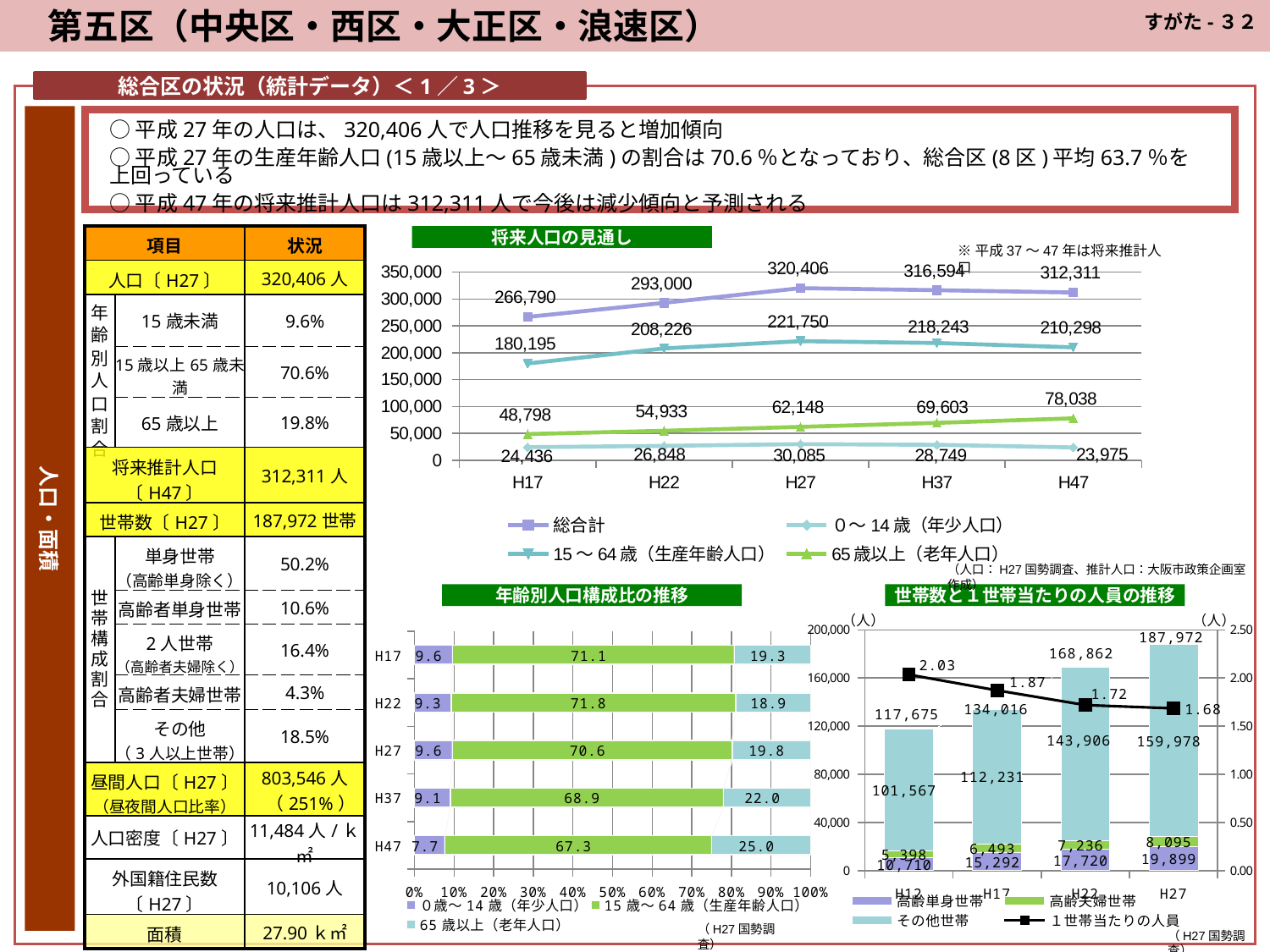
In the 世帯数と1世帯当たりの人員の推移 chart, what is the 1世帯当たりの人員 value for H27? 1.68 In the 将来人口の見通し chart, does the 65歳以上（老年人口） series rise or fall from H17 to H47? rise In the 年齢別人口構成比の推移 chart, what is the 15歳～64歳（生産年齢人口） share for H47? 67.3 In the 将来人口の見通し chart, which year has the highest 総合計 value? H27 What kind of chart is the 年齢別人口構成比の推移 chart? bar chart In the 将来人口の見通し chart, what is the difference between the 総合計 values for H27 and H47? 8,095 In the 年齢別人口構成比の推移 chart, which year has the lowest 0歳～14歳（年少人口） share? H47 In the 将来人口の見通し chart, how many series does the legend list? 4 In the 将来人口の見通し chart, what is the 65歳以上（老年人口） value for H47? 78,038 In the 将来人口の見通し chart, what is the 総合計 value for H27? 320,406 In the 世帯数と1世帯当たりの人員の推移 chart, what is the total number of households for H22? 168,862 In the 世帯数と1世帯当たりの人員の推移 chart, is the その他世帯 value for H27 larger or smaller than the その他世帯 value for H12? larger